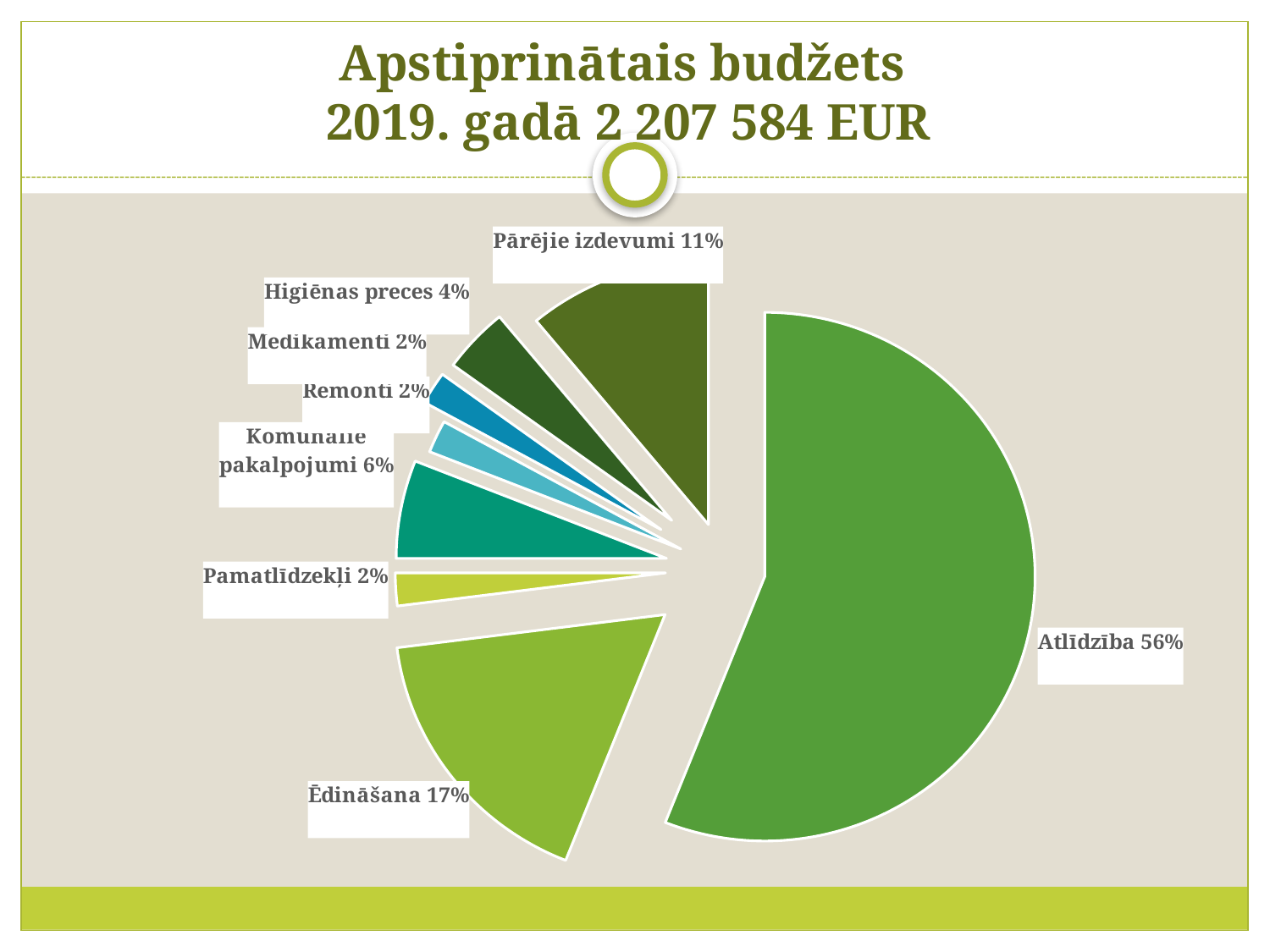
What percentage is shown for Komunālie pakalpojumi? 6% What percentage is shown for Pārējie izdevumi? 11% What is the difference in percentage points between Atlīdzība and Ēdināšana? 39 What kind of chart is shown on the slide? pie chart Which category has the largest share of the pie? Atlīdzība How many slices does the pie chart have? 8 What percentage is shown for Higiēnas preces? 4% What is the difference in percentage points between Ēdināšana and Pārējie izdevumi? 6 What share of the budget goes to Atlīdzība? 56% What total budget amount for 2019 is stated in the slide title? 2 207 584 EUR Which is larger, the share for Pārējie izdevumi or the share for Komunālie pakalpojumi? Pārējie izdevumi What percentage is shown for Ēdināšana? 17%